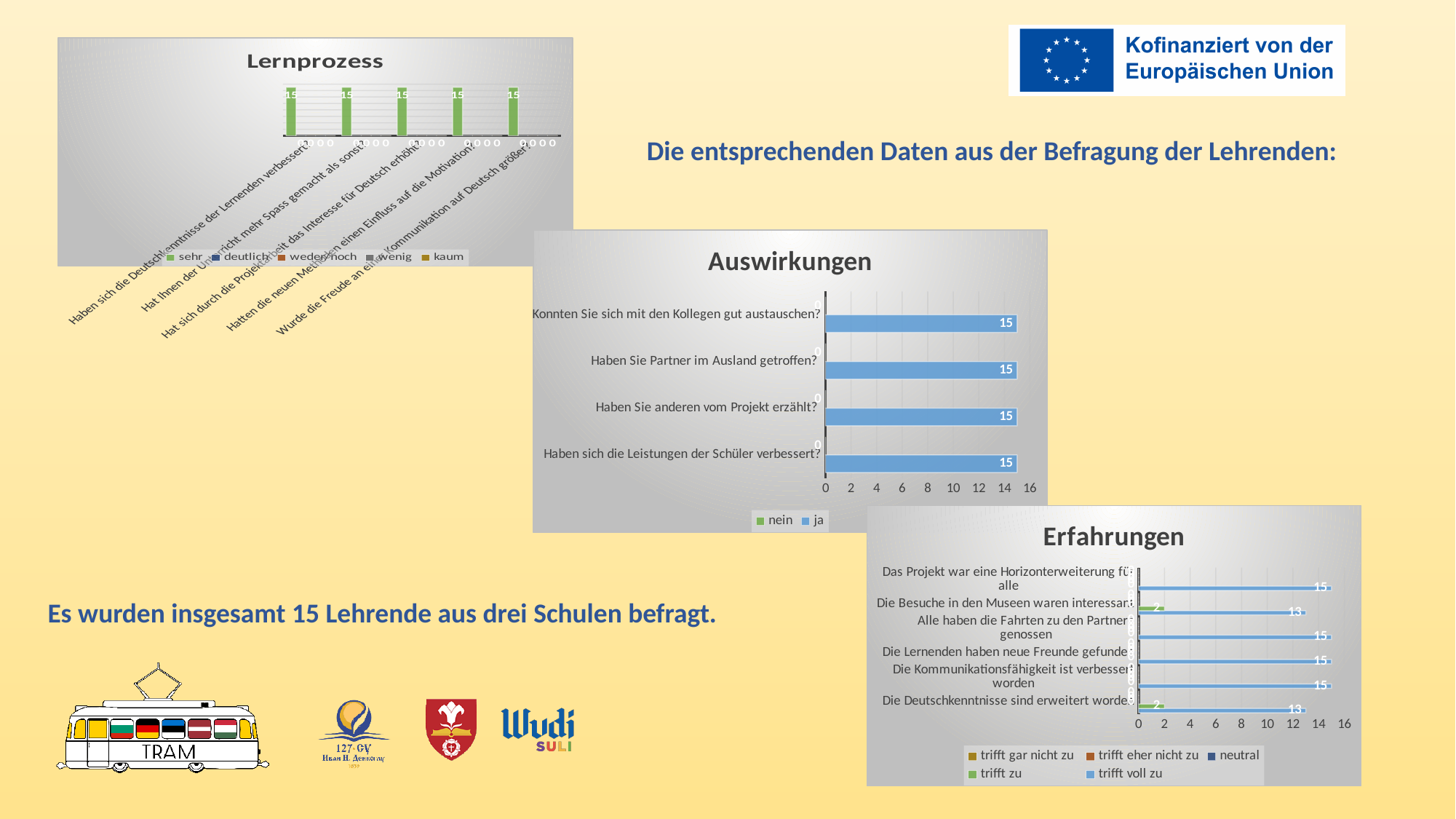
In the 'Erfahrungen' chart, what is the 'trifft voll zu' value for 'Die Besuche in den Museen waren interessant'? 13 What kind of chart is the 'Auswirkungen' chart? bar chart How many series does the legend of the 'Auswirkungen' chart list? 2 In the 'Auswirkungen' chart, what is the 'ja' value for 'Haben Sie Partner im Ausland getroffen?'? 15 In the 'Erfahrungen' chart, what is the difference between the 'trifft voll zu' values for 'Die Lernenden haben neue Freunde gefunden' and 'Die Deutschkenntnisse sind erweitert worden'? 2 In the 'Erfahrungen' chart, which is larger: the 'trifft voll zu' value for 'Das Projekt war eine Horizonterweiterung für alle' or for 'Die Besuche in den Museen waren interessant'? Das Projekt war eine Horizonterweiterung für alle How many series does the legend of the 'Erfahrungen' chart list? 5 How many series does the legend of the 'Lernprozess' chart list? 5 In the 'Lernprozess' chart, what is the 'sehr' value for 'Haben sich die Deutschkenntnisse der Lernenden verbessert?'? 15 In the 'Erfahrungen' chart, how many categories (statements) are shown? 6 In the 'Erfahrungen' chart, what is the 'trifft zu' value for 'Die Deutschkenntnisse sind erweitert worden'? 2 In the 'Auswirkungen' chart, how many categories (questions) are shown? 4